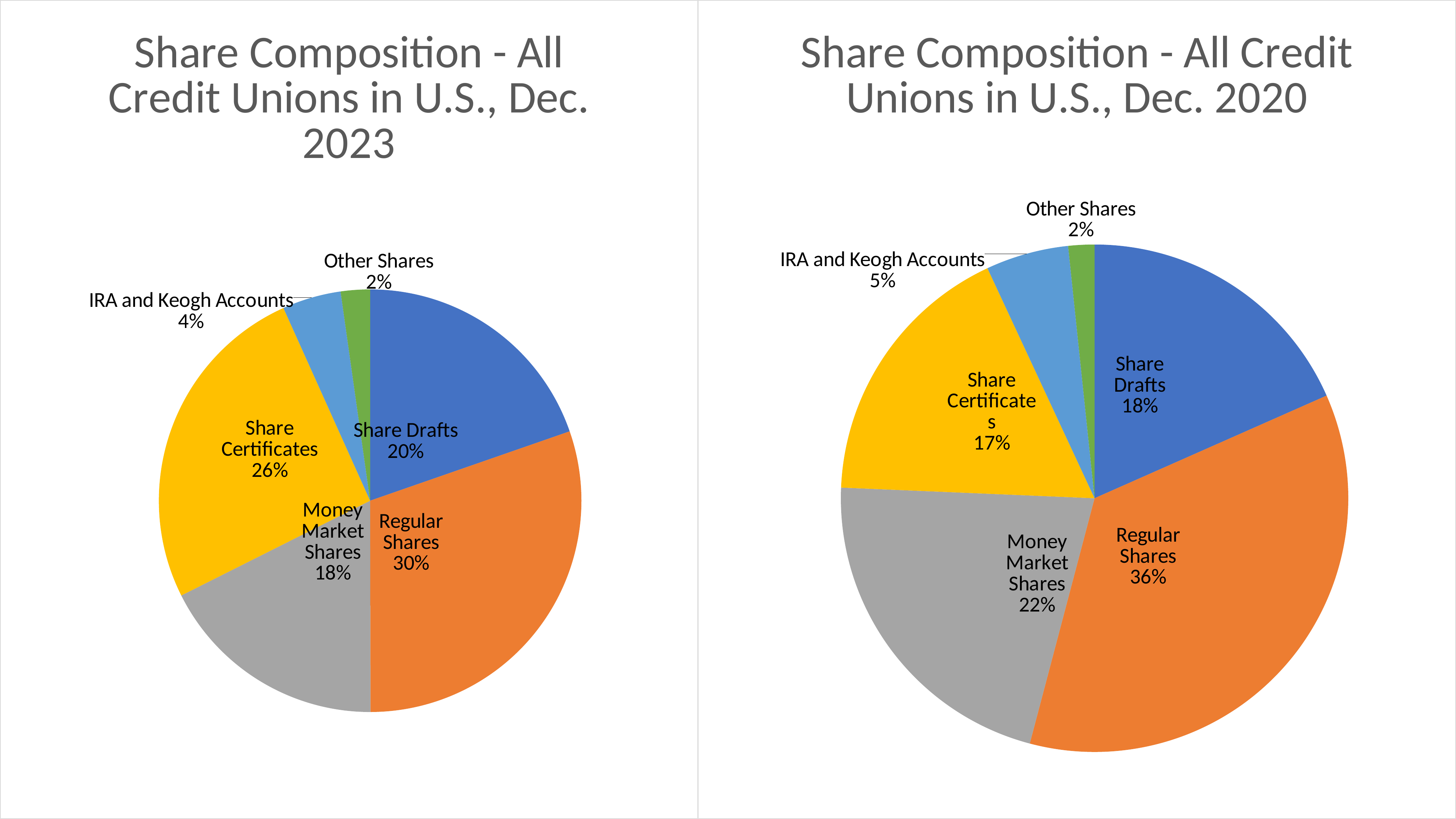
In the Dec. 2023 chart, which is larger: Share Certificates or Money Market Shares? Share Certificates In the Dec. 2023 chart, what is the difference between Share Certificates and Share Drafts? 6% In the Dec. 2020 chart, which category has the smallest share? Other Shares How many categories does the Dec. 2023 chart show? 6 In the Dec. 2023 chart, what share do IRA and Keogh Accounts hold? 4% In the Dec. 2020 chart, what share do Money Market Shares hold? 22% In the Dec. 2023 chart, what share do Regular Shares hold? 30% In the Dec. 2023 chart, which category has the largest share? Regular Shares What kind of chart is the Dec. 2020 chart? Pie chart What is the title of the chart on the right side of the slide? Share Composition - All Credit Unions in U.S., Dec. 2020 In the Dec. 2020 chart, what is the difference between Regular Shares and Share Drafts? 18% In the Dec. 2020 chart, which is larger: Money Market Shares or Share Certificates? Money Market Shares